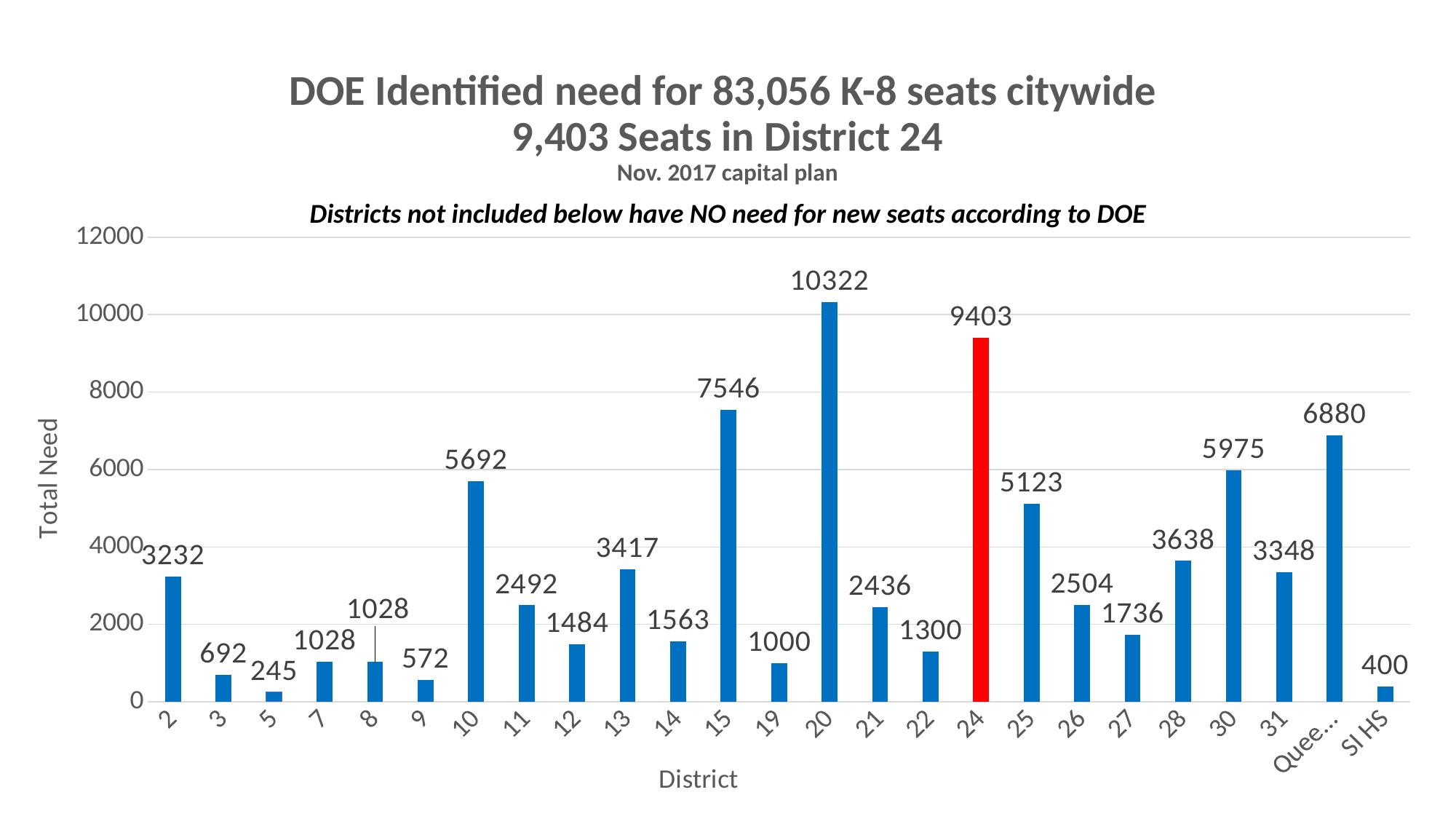
Which district has the highest total need? 20 Which district's bar is coloured red? 24 What is the total need for District 15? 7546 What is the difference in total need between District 20 and District 24? 919 What kind of chart is shown on the slide? Bar chart Is the value for District 28 greater or less than 4000? less Which has a larger total need, District 10 or District 30? District 30 How many districts are shown on the x axis? 25 What is the total need for District 24? 9403 What is the total need for SI HS? 400 What is the label of the y axis? Total Need Which district has the lowest total need? 5